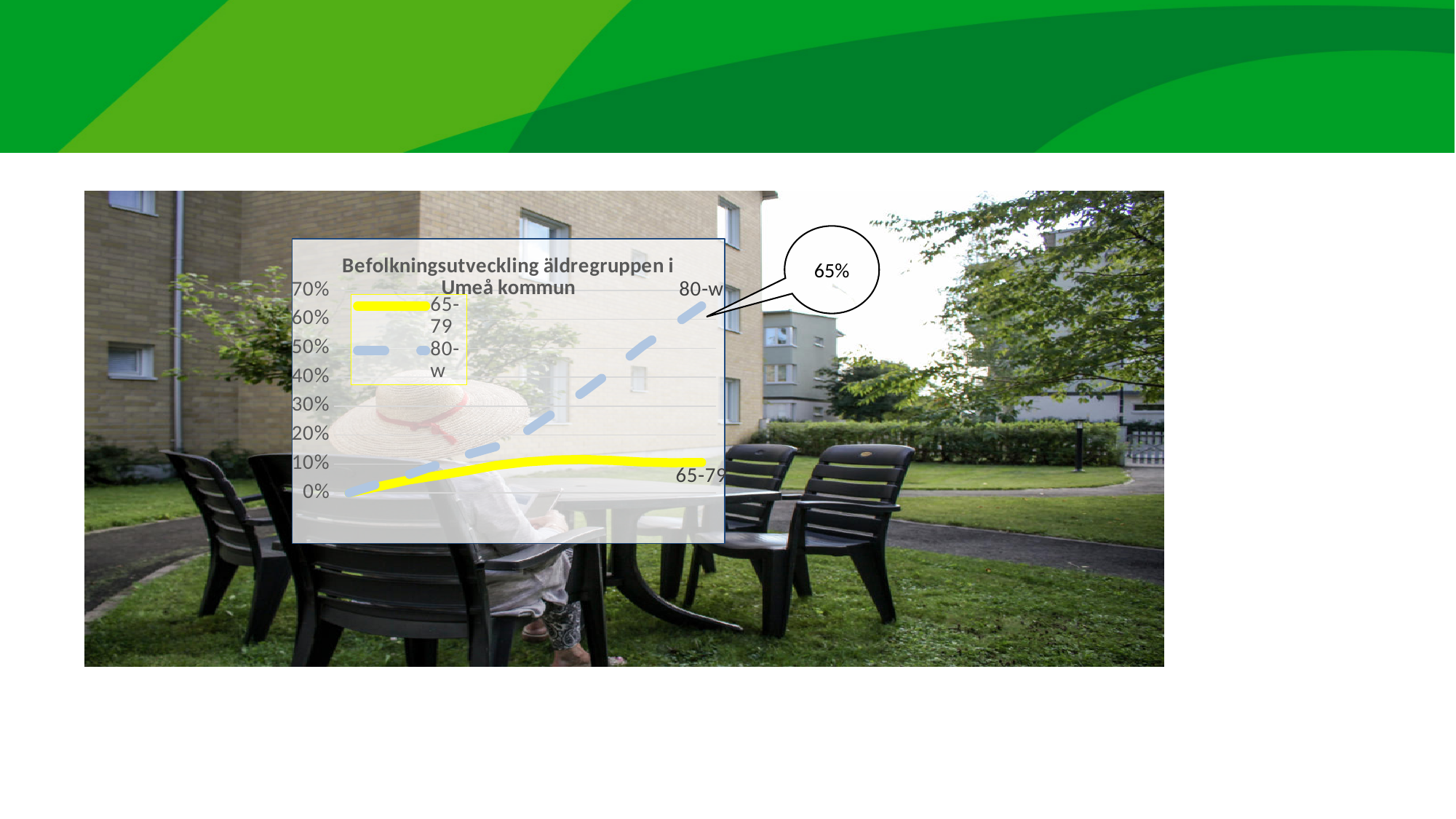
What value does the callout give for the end of the 80-w line? 65% Is the final value of the 80-w line greater or less than 50%? greater Which series reaches the higher value at the right end of the chart, 65-79 or 80-w? 80-w What is the title of the chart? Befolkningsutveckling äldregruppen i Umeå kommun What is the highest value shown on the chart's vertical axis? 70% What kind of chart is shown on the slide? line chart Does the 65-79 line rise or fall along the x axis? rise Which two series are listed in the chart's legend? 65-79 and 80-w Is the final value of the 65-79 line greater or less than 20%? less Does the 80-w line rise or fall along the x axis? rise Which series has the lowest value at the right end of the chart? 65-79 How many series does the chart's legend list? 2